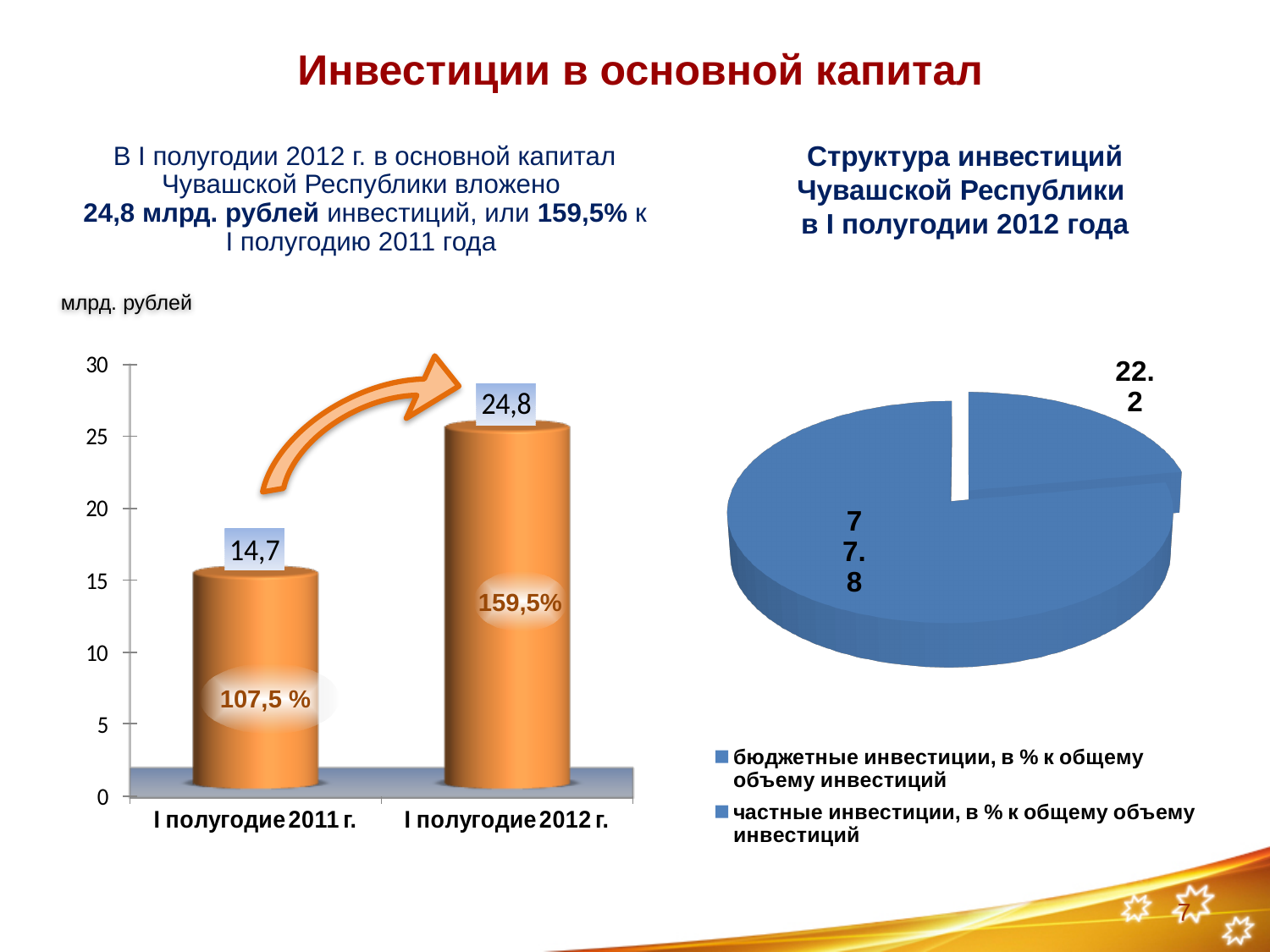
On the left bar chart, what is the value for I полугодие 2012 г.? 24,8 What kind of chart is the chart on the left of the slide? bar chart On the left bar chart, what is the difference between the values for I полугодие 2012 г. and I полугодие 2011 г.? 10,1 On the left bar chart, what percentage label is printed on the bar for I полугодие 2012 г.? 159,5% On the left bar chart, what is the value for I полугодие 2011 г.? 14,7 On the left bar chart, how many categories are shown on the x axis? 2 On the pie chart 'Структура инвестиций Чувашской Республики в I полугодии 2012 года', how many entries does the legend list? 2 On the left bar chart, which category has the lowest value? I полугодие 2011 г. On the left bar chart, do the values rise or fall from I полугодие 2011 г. to I полугодие 2012 г.? rise On the left bar chart, which category has the highest value? I полугодие 2012 г. What kind of chart is the chart titled 'Структура инвестиций Чувашской Республики в I полугодии 2012 года'? pie chart On the pie chart 'Структура инвестиций Чувашской Республики в I полугодии 2012 года', what is the value of the largest slice? 77.8